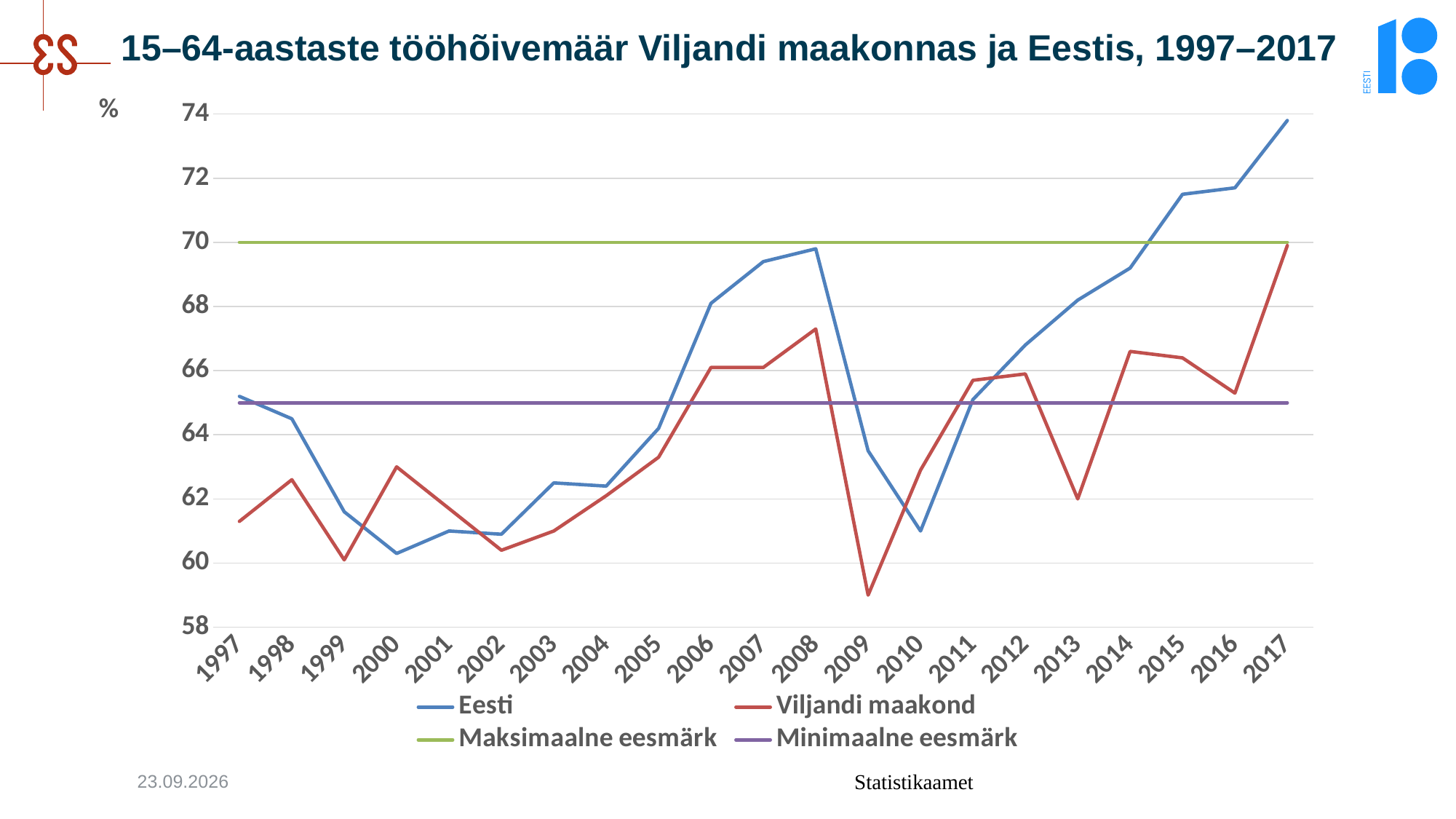
In which year is the Eesti line at its highest? 2017 How many years are shown on the x axis? 21 Is the value for Eesti in 2017 greater or less than 72? greater In which year is the Viljandi maakond line at its highest? 2017 Is the value for Eesti in 2015 greater or less than 70? greater What kind of chart is shown on the slide? line chart In which year is the Viljandi maakond line at its lowest? 2009 What value does the Maksimaalne eesmärk line sit at? 70 Is the value for Viljandi maakond in 2009 greater or less than 60? less How many series does the legend list? 4 In 2009, which is larger: Eesti or Viljandi maakond? Eesti Does the Eesti line rise or fall from 2010 to 2017? rise